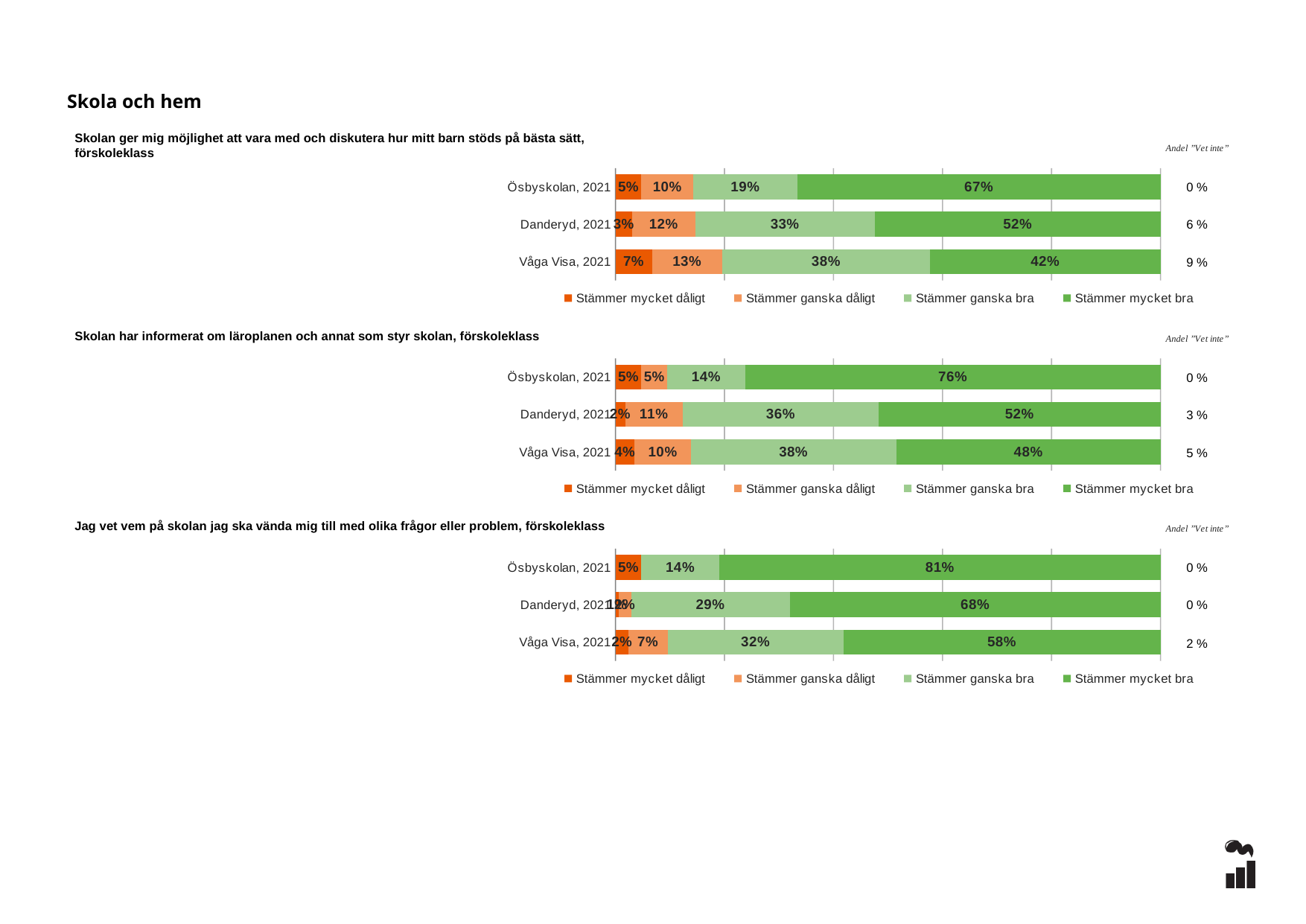
How many series does the legend of the middle chart list? 4 In the top chart (Skolan ger mig möjlighet att vara med och diskutera...), what is the 'Stämmer mycket bra' value for Ösbyskolan, 2021? 67% In the top chart (Skolan ger mig möjlighet att vara med och diskutera...), what is the 'Andel Vet inte' value for Våga Visa, 2021? 9 % In the bottom chart (Jag vet vem på skolan jag ska vända mig till...), what is the 'Stämmer ganska dåligt' value for Våga Visa, 2021? 7% In the middle chart (Skolan har informerat om läroplanen...), which row has the lowest 'Stämmer mycket bra' value? Våga Visa, 2021 In the top chart (Skolan ger mig möjlighet att vara med och diskutera...), what is the difference between the 'Stämmer ganska bra' values for Våga Visa, 2021 and Ösbyskolan, 2021? 19 percentage points In the bottom chart (Jag vet vem på skolan jag ska vända mig till...), what is the 'Stämmer mycket bra' value for Ösbyskolan, 2021? 81% In the middle chart (Skolan har informerat om läroplanen...), is the 'Stämmer ganska bra' value larger for Danderyd, 2021 or Ösbyskolan, 2021? Danderyd, 2021 In the top chart (Skolan ger mig möjlighet att vara med och diskutera...), which row has the highest 'Stämmer mycket bra' value? Ösbyskolan, 2021 What kind of chart is the top chart on the slide? Stacked bar chart In the middle chart (Skolan har informerat om läroplanen...), what is the 'Stämmer mycket bra' value for Ösbyskolan, 2021? 76% In the bottom chart (Jag vet vem på skolan jag ska vända mig till...), what is the difference between the 'Stämmer mycket bra' values for Danderyd, 2021 and Våga Visa, 2021? 10 percentage points